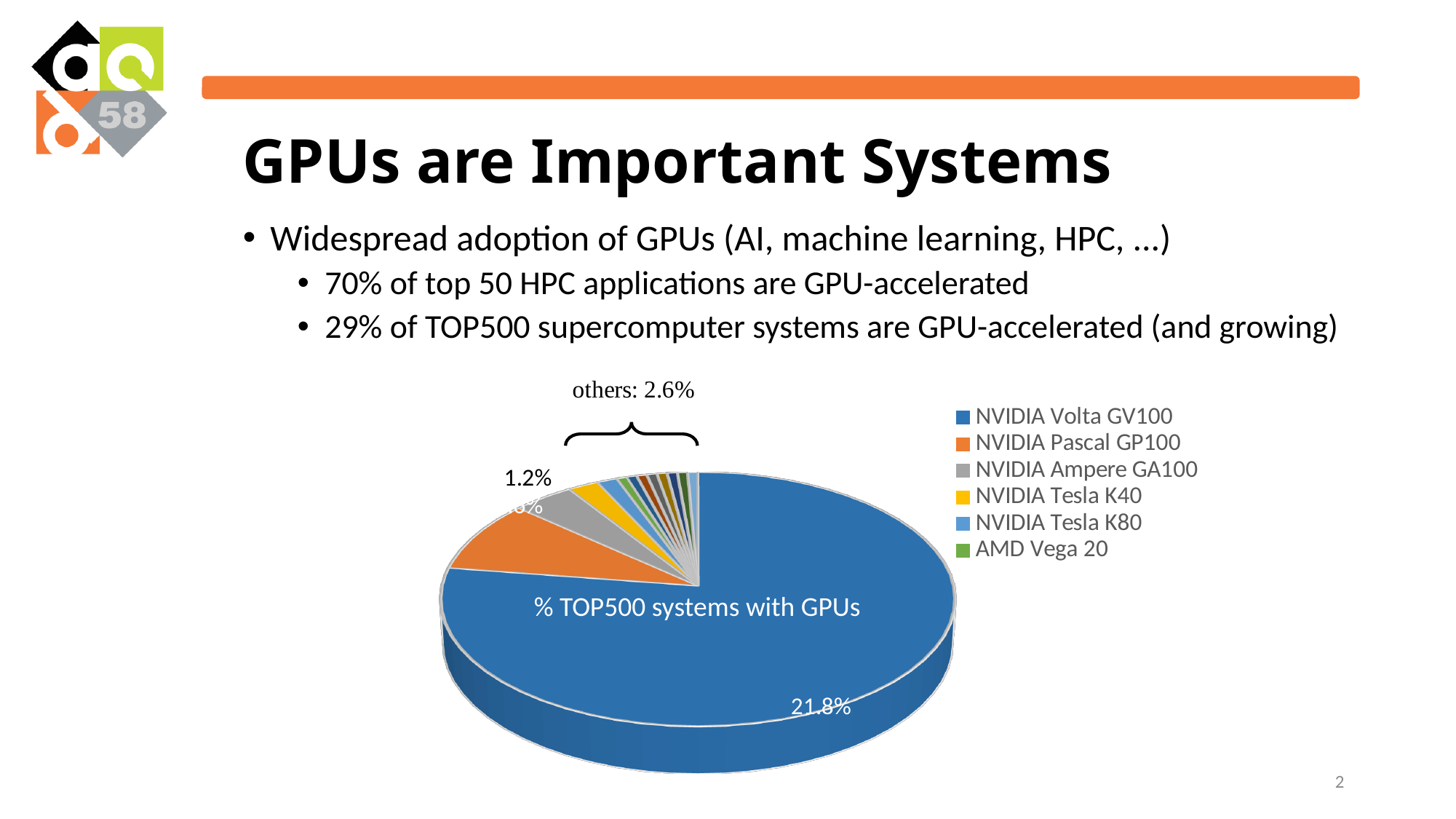
What percentage is labelled on the NVIDIA Volta GV100 slice of the pie chart? 21.8% What is the smallest percentage value printed as a slice label on the pie chart? 1.2% Which GPU has the largest slice in the pie chart? NVIDIA Volta GV100 Which slice is larger in the pie chart, NVIDIA Pascal GP100 or NVIDIA Ampere GA100? NVIDIA Pascal GP100 What percentage does the 'others' annotation on the pie chart give? 2.6% How many entries does the pie chart's legend list? 6 Which slice is larger in the pie chart, NVIDIA Volta GV100 or NVIDIA Pascal GP100? NVIDIA Volta GV100 What colour is the NVIDIA Volta GV100 slice in the pie chart? blue What kind of chart is shown on the slide? pie chart What is the title shown on the pie chart? % TOP500 systems with GPUs By how many percentage points does the NVIDIA Volta GV100 slice (21.8%) exceed the 'others' group (2.6%)? 19.2 Which GPU is listed last in the pie chart's legend? AMD Vega 20